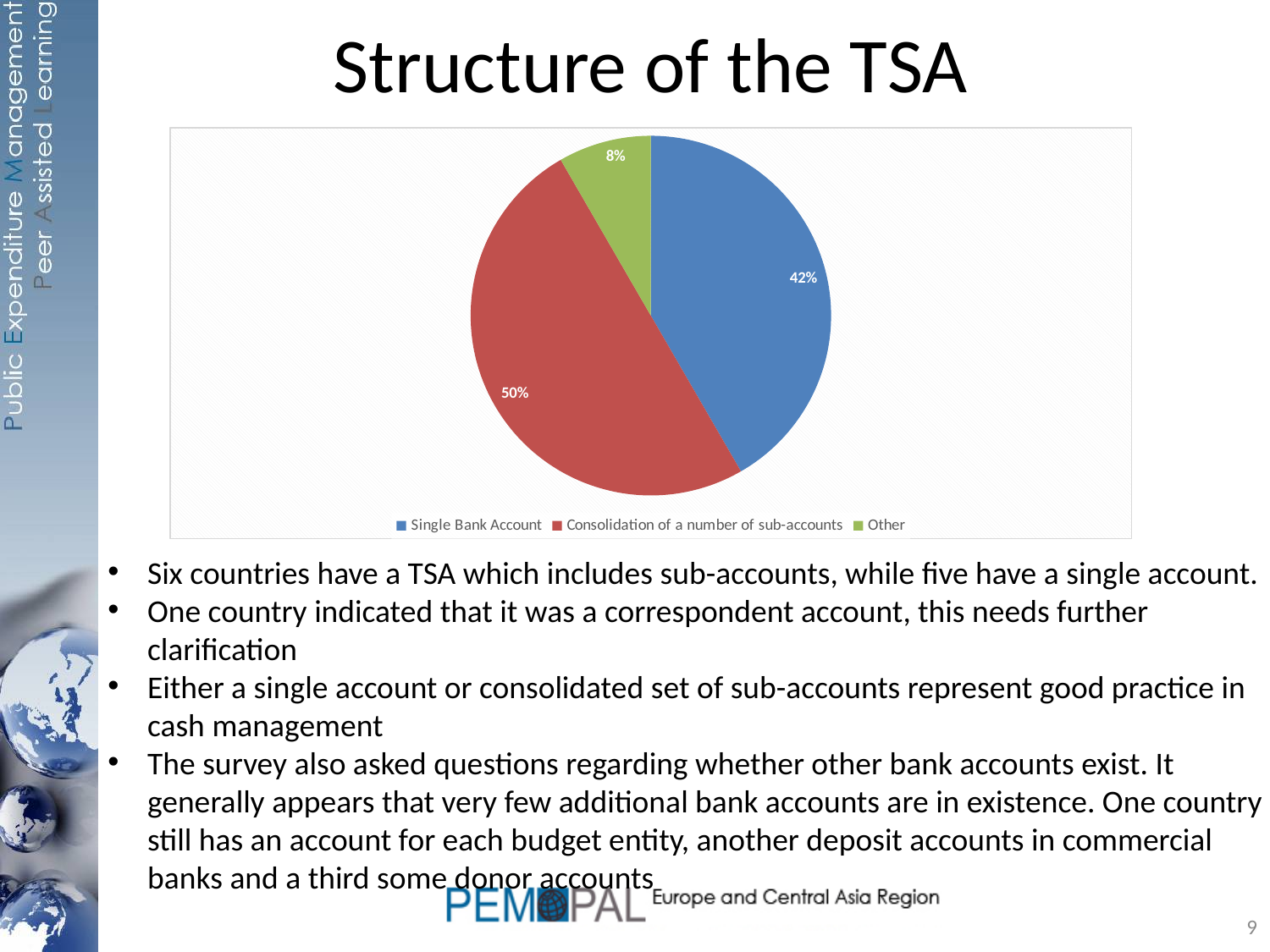
What share of the pie does Other represent? 8% Where is the legend positioned on the chart? at the bottom What is the difference in percentage points between Single Bank Account and Other? 34 What colour is the slice for Consolidation of a number of sub-accounts? red How many categories does the pie chart show? 3 Which category has the largest slice of the pie? Consolidation of a number of sub-accounts What is the difference in percentage points between Consolidation of a number of sub-accounts and Single Bank Account? 8 What share of the pie does Consolidation of a number of sub-accounts represent? 50% What share of the pie does Single Bank Account represent? 42% Which category has the smallest slice of the pie? Other Which is larger, the slice for Single Bank Account or the slice for Other? Single Bank Account What kind of chart is shown on the slide? pie chart